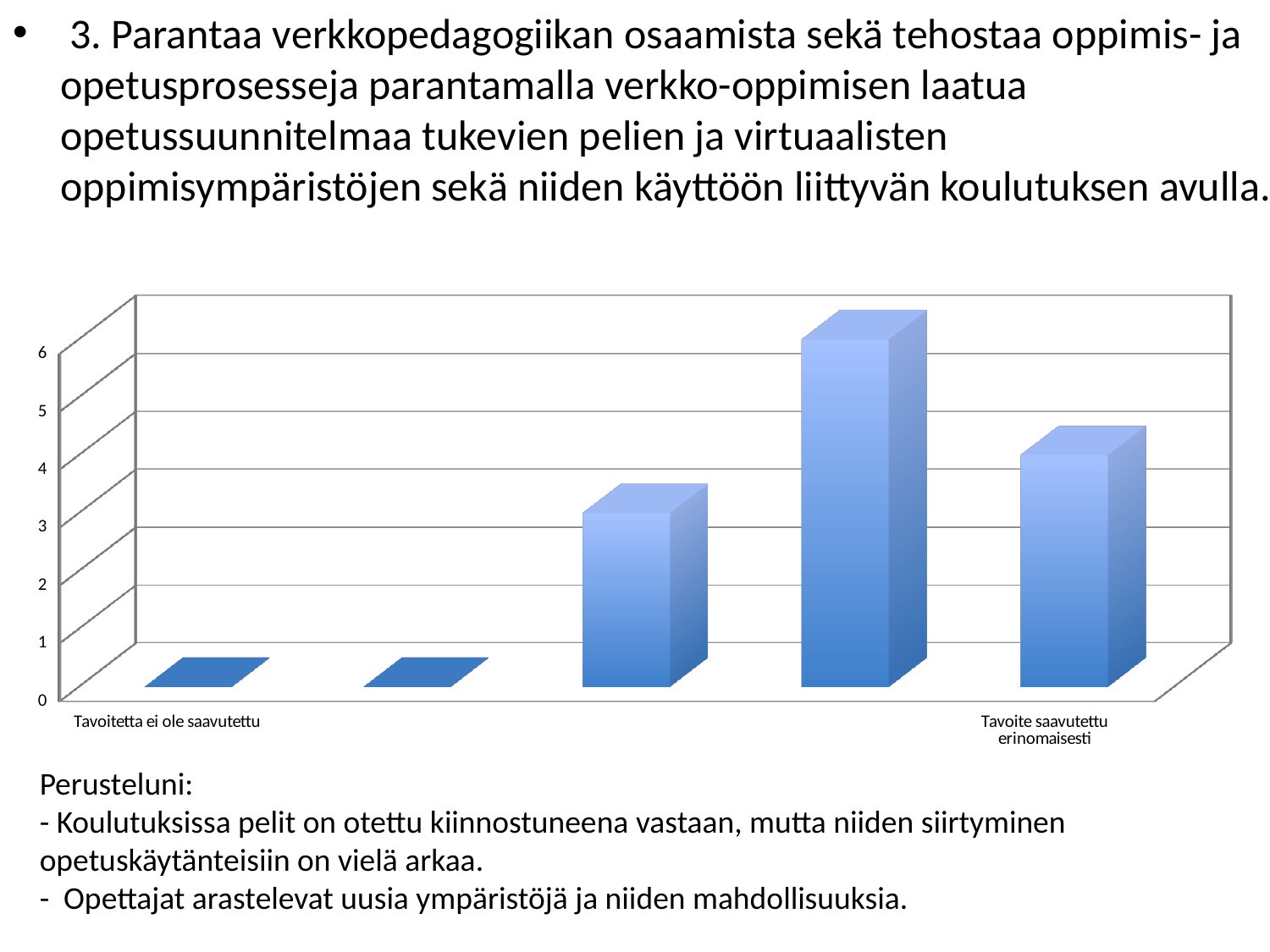
How many bars in the chart are taller than 2? 3 Is the value for "Tavoite saavutettu erinomaisesti" greater or less than 5? less Which is larger, the value for "Tavoitetta ei ole saavutettu" or the value for "Tavoite saavutettu erinomaisesti"? Tavoite saavutettu erinomaisesti What colour are the bars in the chart? blue What is the value for "Tavoitetta ei ole saavutettu"? 0 What kind of chart is shown on the slide? bar chart How many bars are plotted in the chart? 5 Is the value for "Tavoite saavutettu erinomaisesti" greater or less than 2? greater How many bars in the chart have a value of 0? 2 Is the bar for "Tavoite saavutettu erinomaisesti" the tallest bar in the chart? No Is the value for "Tavoitetta ei ole saavutettu" greater or less than 1? less What is the highest tick value shown on the vertical axis? 6